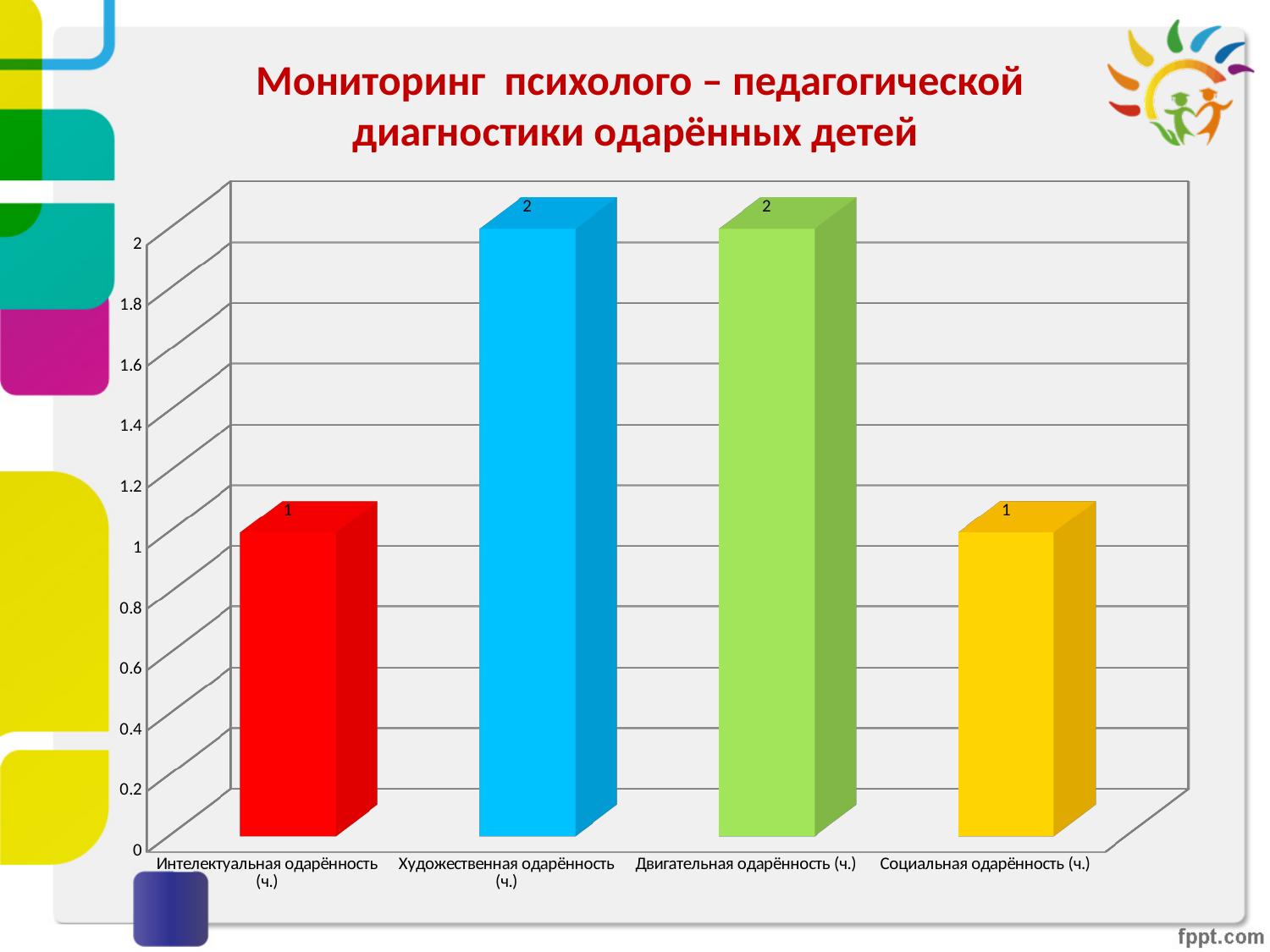
How many categories are shown on the x axis of the chart? 4 What is the value for Художественная одарённость (ч.)? 2 Which is larger, the value for Художественная одарённость (ч.) or the value for Интелектуальная одарённость (ч.)? Художественная одарённость (ч.) What is the value for Социальная одарённость (ч.)? 1 Which is larger, the value for Социальная одарённость (ч.) or the value for Двигательная одарённость (ч.)? Двигательная одарённость (ч.) Is the value for Двигательная одарённость (ч.) greater or less than 1.4? greater What is the value for Двигательная одарённость (ч.)? 2 What is the difference between the values for Художественная одарённость (ч.) and Социальная одарённость (ч.)? 1 What is the title of the slide containing the chart? Мониторинг психолого – педагогической диагностики одарённых детей What is the value for Интелектуальная одарённость (ч.)? 1 Is the value for Интелектуальная одарённость (ч.) greater or less than 1.6? less What kind of chart is shown on the slide? Bar chart